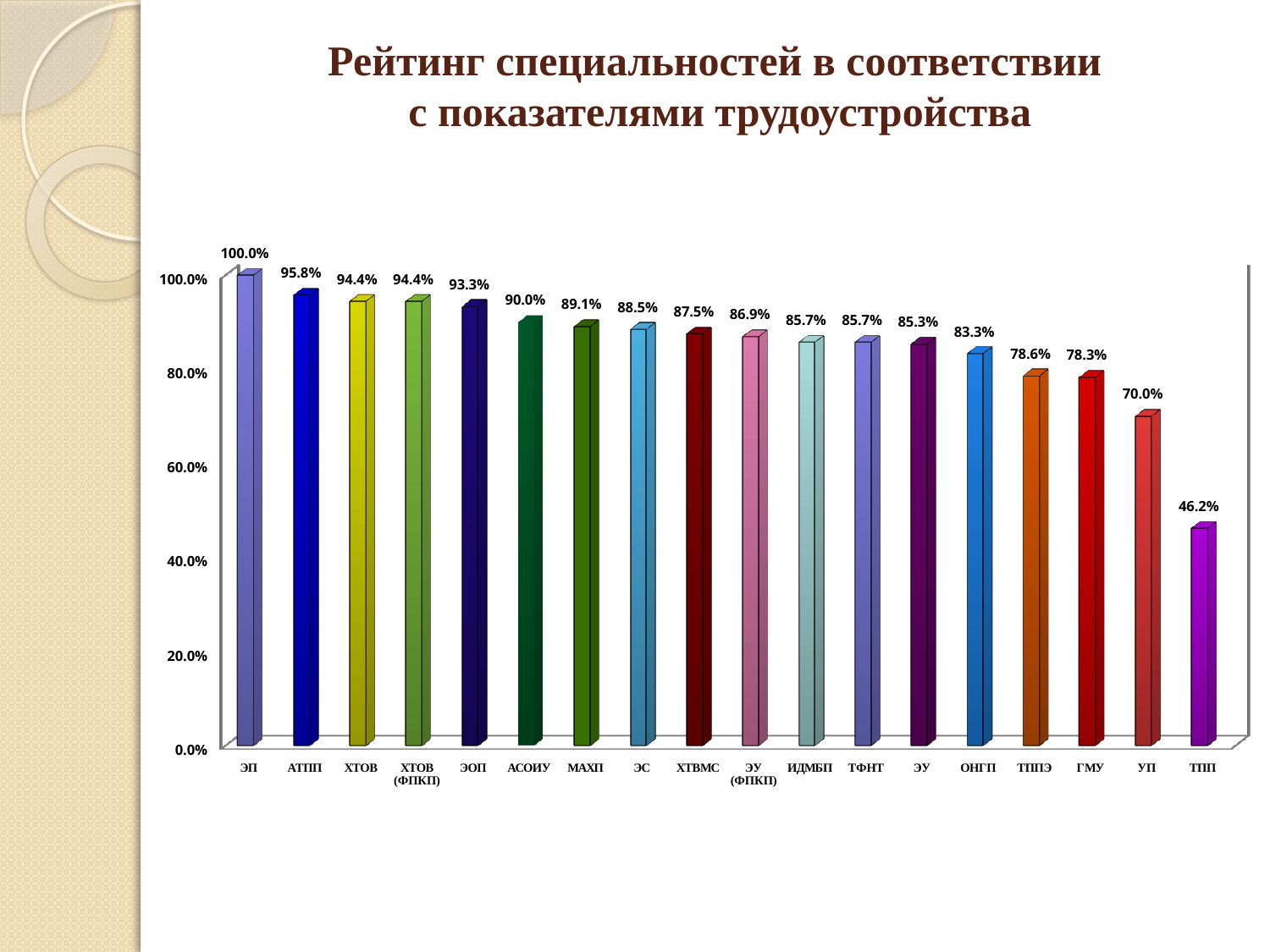
Is the value for ТПП greater or less than 60.0%? less What is the value for ТПП? 46.2% What is the difference between the values for ЭП and ТПП? 53.8% Which category has the highest value? ЭП What is the value for АТПП? 95.8% Which category has the lowest value? ТПП What is the difference between the values for ТППЭ and ГМУ? 0.3% Which is larger, the value for АСОИУ or the value for УП? АСОИУ What is the value for ОНГП? 83.3% Do the values rise or fall from left to right along the x axis? fall What kind of chart is shown on the slide? bar chart How many categories are shown on the x axis? 18